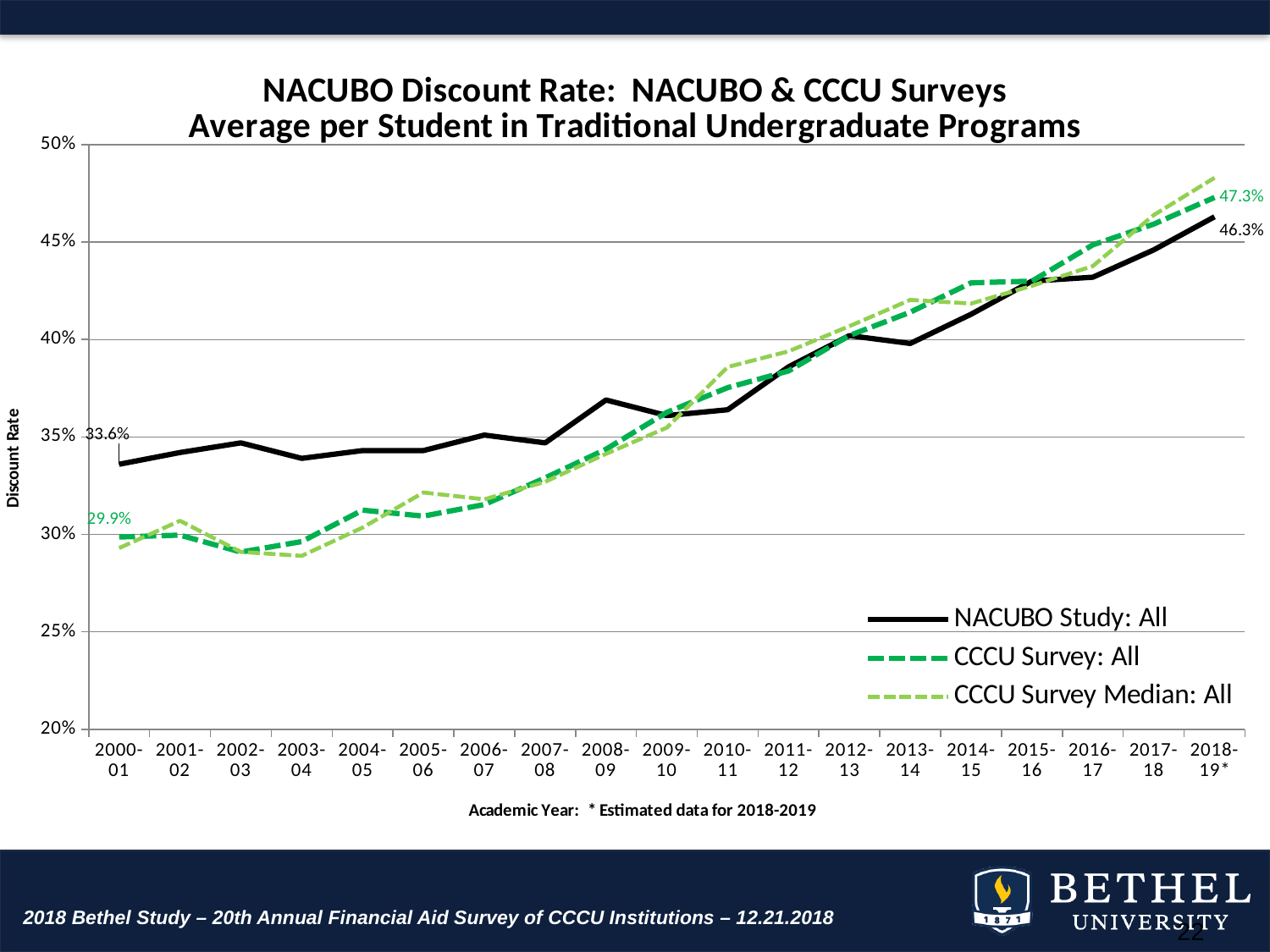
What is the CCCU Survey: All discount rate for 2000-01? 29.9% What is the CCCU Survey: All discount rate for 2018-19? 47.3% Does the NACUBO Study: All discount rate generally rise or fall from 2000-01 to 2018-19? Rise What is the NACUBO Study: All discount rate for 2018-19? 46.3% What is the NACUBO Study: All discount rate for 2000-01? 33.6% What kind of chart is shown on the slide? Line chart By how many percentage points did the NACUBO Study: All discount rate increase from 2000-01 to 2018-19? 12.7 percentage points How many series does the legend list? 3 How many academic years are shown along the x axis? 19 By how many percentage points did the CCCU Survey: All discount rate increase from 2000-01 to 2018-19? 17.4 percentage points In 2018-19, which is higher: the NACUBO Study: All rate or the CCCU Survey: All rate? CCCU Survey: All Is the CCCU Survey Median: All value for 2003-04 greater or less than 30%? less